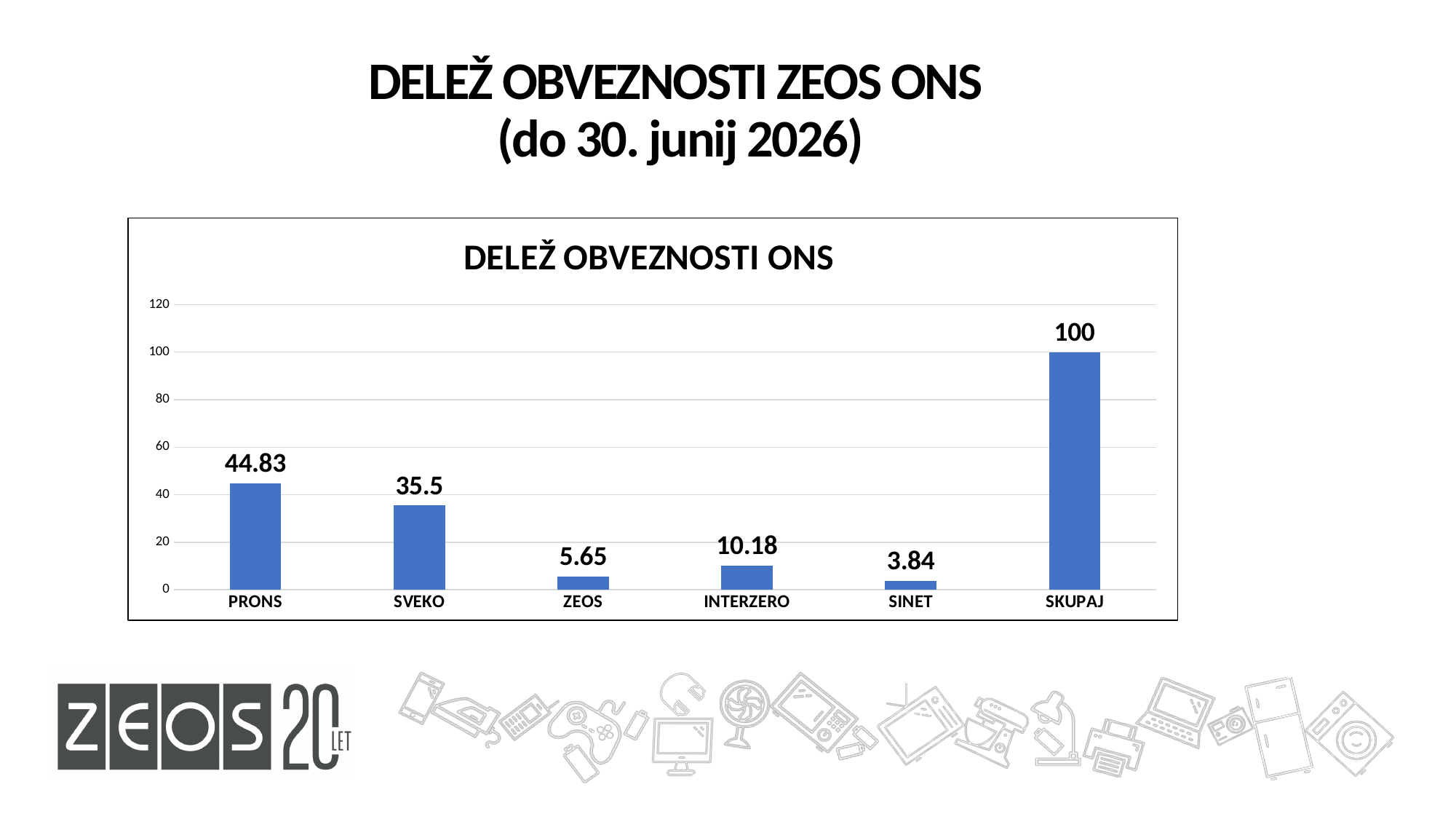
What is the value for INTERZERO? 10.18 Which category has the lowest value? SINET Which category has the highest value? SKUPAJ Is the value for SVEKO greater or less than 40? less Which is larger, the value for ZEOS or the value for INTERZERO? INTERZERO What is the title of the chart? DELEŽ OBVEZNOSTI ONS What is the value for SINET? 3.84 What is the value for SVEKO? 35.5 What is the difference between the values for PRONS and SVEKO? 9.33 How many categories are shown on the x axis? 6 What is the value for PRONS? 44.83 What kind of chart is shown? bar chart